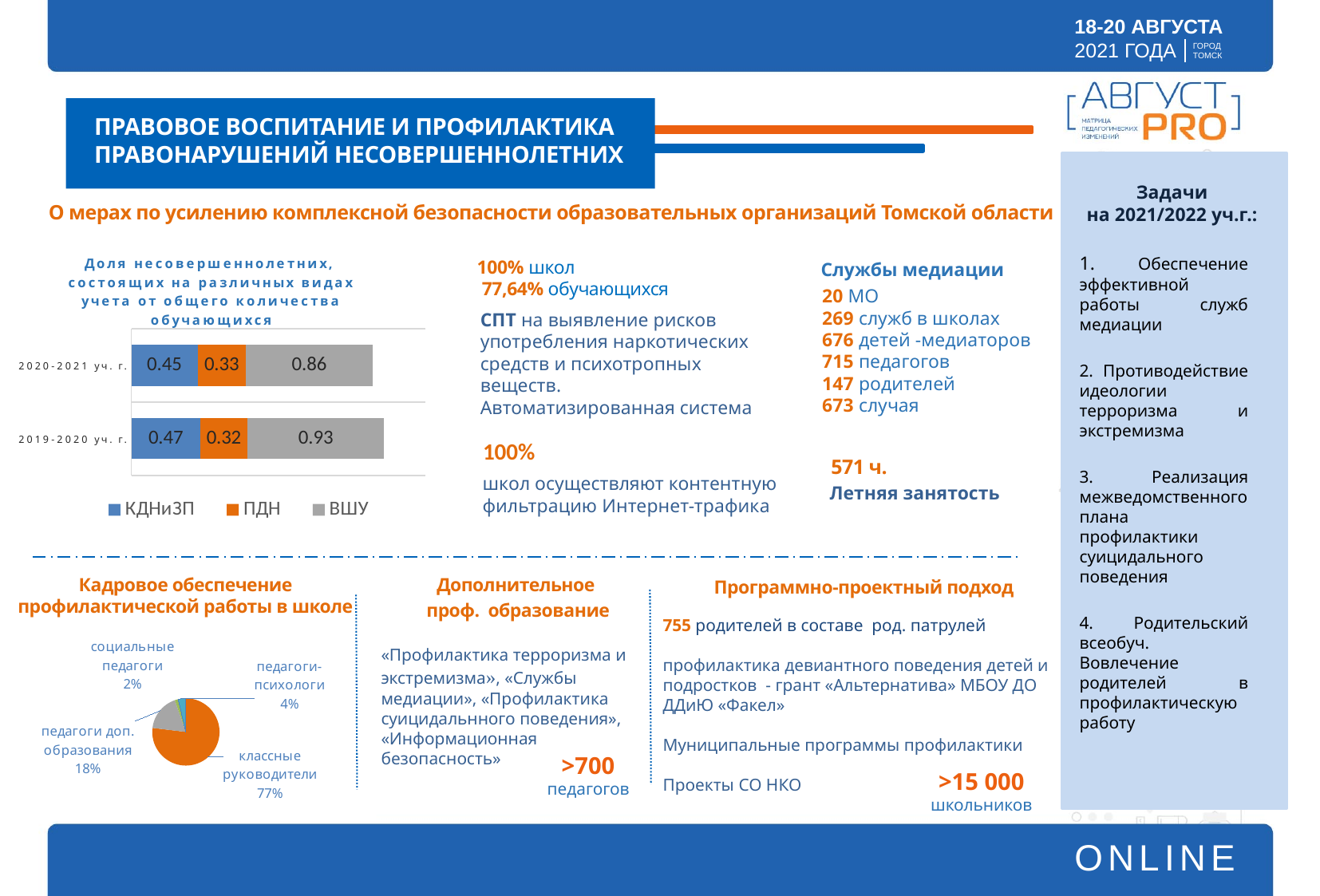
In the pie chart under 'Кадровое обеспечение профилактической работы в школе', how many categories are shown? 4 In the stacked bar chart 'Доля несовершеннолетних, состоящих на различных видах учета', what is the value for ПДН in 2020-2021 уч. г.? 0.33 In the stacked bar chart 'Доля несовершеннолетних, состоящих на различных видах учета', what is the value for ВШУ in 2020-2021 уч. г.? 0.86 In the stacked bar chart 'Доля несовершеннолетних, состоящих на различных видах учета', what is the value for КДНиЗП in 2019-2020 уч. г.? 0.47 In the stacked bar chart 'Доля несовершеннолетних, состоящих на различных видах учета', what is the total of the 2020-2021 уч. г. bar? 1.64 What type of chart is used for 'Доля несовершеннолетних, состоящих на различных видах учета'? Stacked bar chart In the stacked bar chart 'Доля несовершеннолетних, состоящих на различных видах учета', what is the total of the 2019-2020 уч. г. bar? 1.72 In the stacked bar chart 'Доля несовершеннолетних, состоящих на различных видах учета', which series has the largest value in 2020-2021 уч. г.? ВШУ In the pie chart under 'Кадровое обеспечение профилактической работы в школе', which category has the smallest share? социальные педагоги In the pie chart under 'Кадровое обеспечение профилактической работы в школе', what share do классные руководители have? 77% In the stacked bar chart 'Доля несовершеннолетних, состоящих на различных видах учета', how many series does the legend list? 3 In the stacked bar chart 'Доля несовершеннолетних, состоящих на различных видах учета', what is the difference between the ВШУ values for 2019-2020 and 2020-2021? 0.07